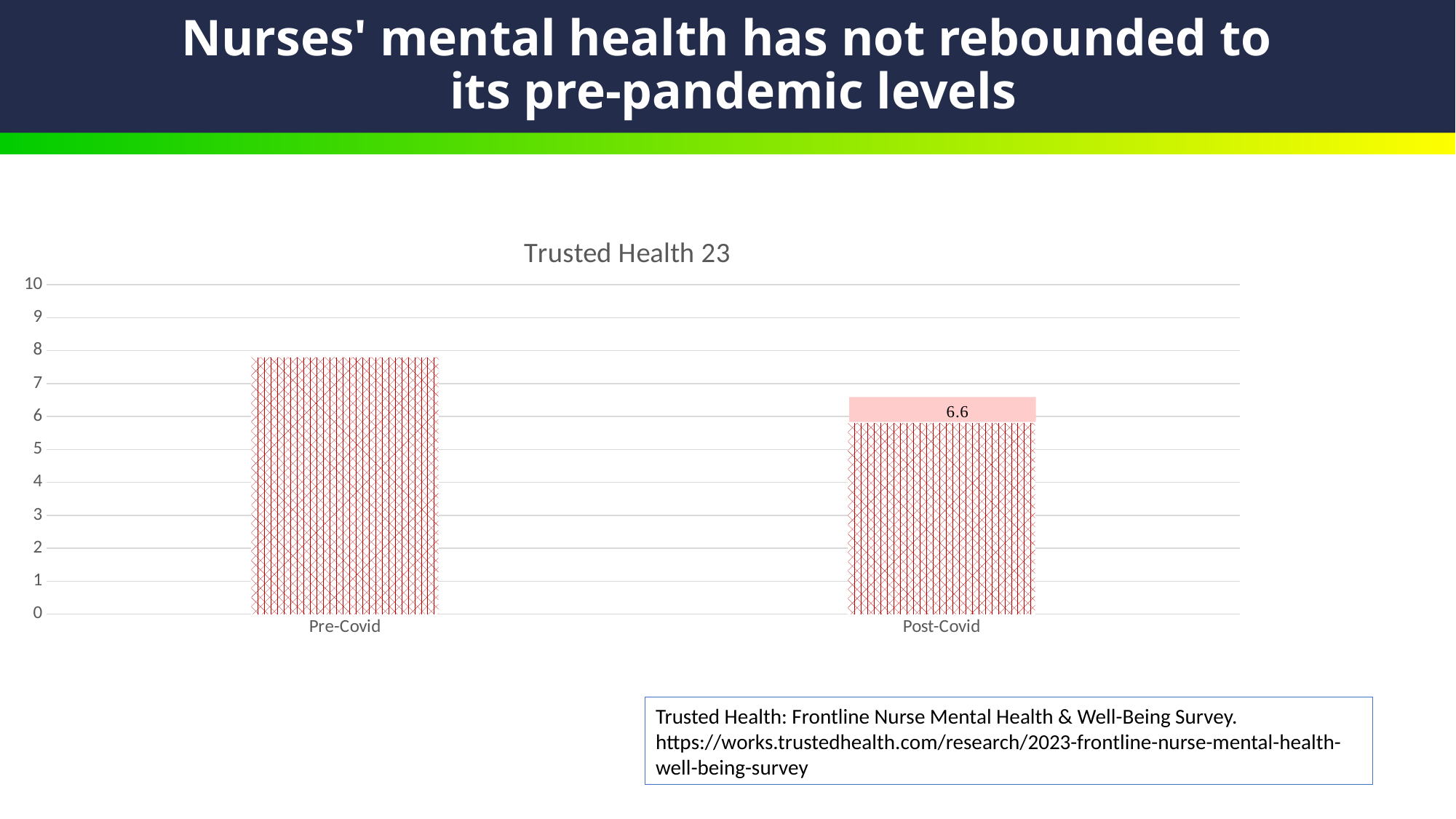
Is the value for Post-Covid greater or less than 7? less Which category has the highest value? Pre-Covid Do the values rise or fall from Pre-Covid to Post-Covid? fall What is the title of the chart? Trusted Health 23 What kind of chart is shown on the slide? bar chart How many categories are shown on the x axis? 2 Is the value for Pre-Covid greater or less than 8? less Is the value for Pre-Covid greater or less than 7? greater Which category has the higher bar, Pre-Covid or Post-Covid? Pre-Covid What is the maximum value shown on the vertical axis? 10 Which category has the lowest value? Post-Covid